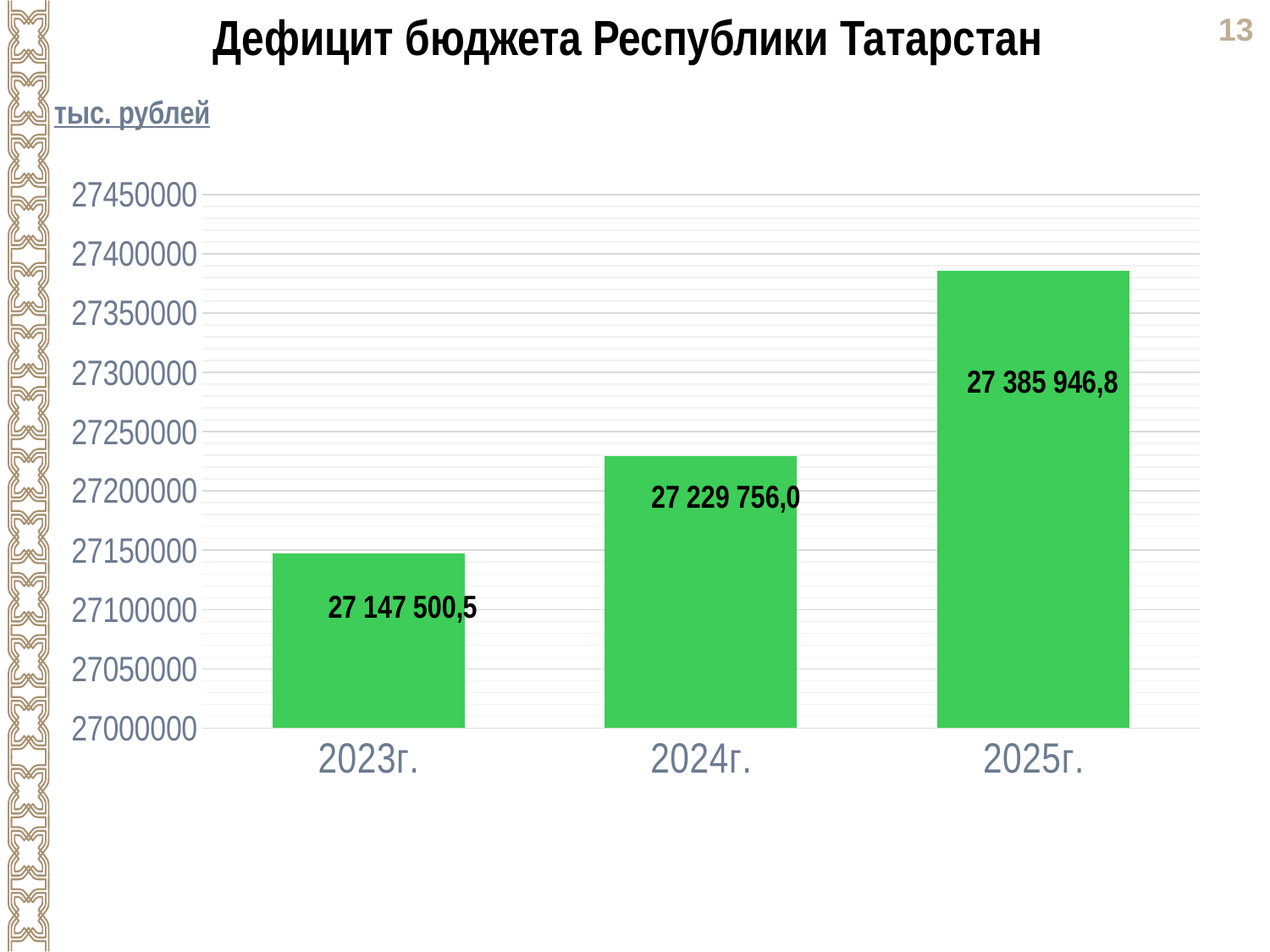
Is the value for 2025г. greater or less than 27350000? greater Which year has the lowest value? 2023г. What is the difference between the values for 2024г. and 2023г.? 82 255,5 What is the value for 2025г.? 27 385 946,8 What kind of chart is shown on the slide? bar chart Which is larger, the value for 2024г. or the value for 2025г.? 2025г. What is the difference between the values for 2025г. and 2024г.? 156 190,8 Do the values rise or fall from 2023г. to 2025г.? rise Which year has the highest value? 2025г. What is the value for 2024г.? 27 229 756,0 What is the value for 2023г.? 27 147 500,5 How many years are shown on the chart? 3